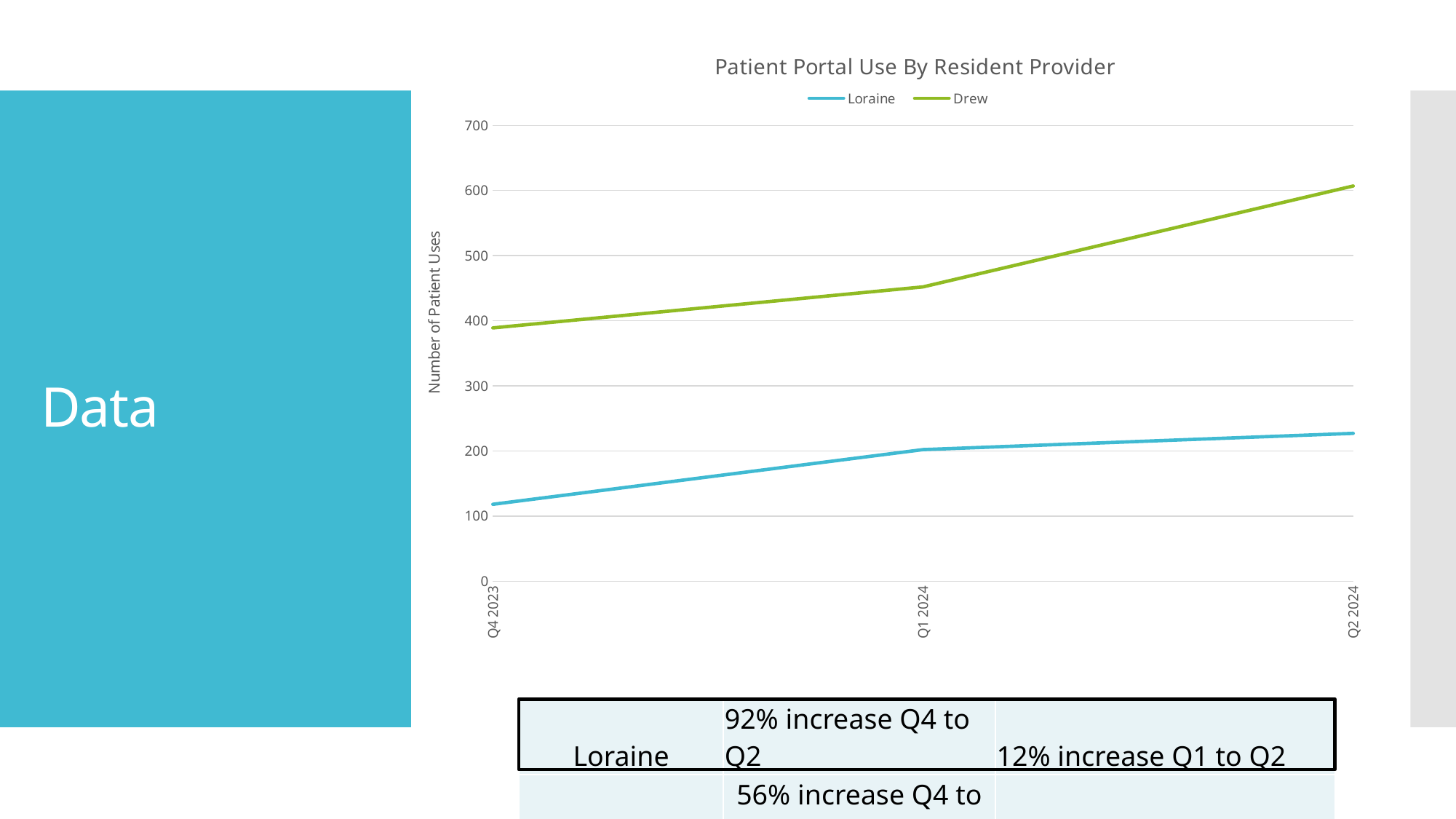
What is the label of the vertical axis? Number of Patient Uses How many series does the chart's legend list? 2 In which quarter does Loraine reach her highest value? Q2 2024 Do the values for Drew rise or fall from Q4 2023 to Q2 2024? rise What kind of chart is shown on the slide? line chart Is the value for Drew in Q1 2024 greater or less than 400? greater Is the value for Drew in Q2 2024 greater or less than 500? greater What is the title of the chart? Patient Portal Use By Resident Provider Is the value for Loraine in Q4 2023 greater or less than 200? less How many time points are plotted along the x axis? 3 Which provider has the higher value in Q2 2024, Loraine or Drew? Drew